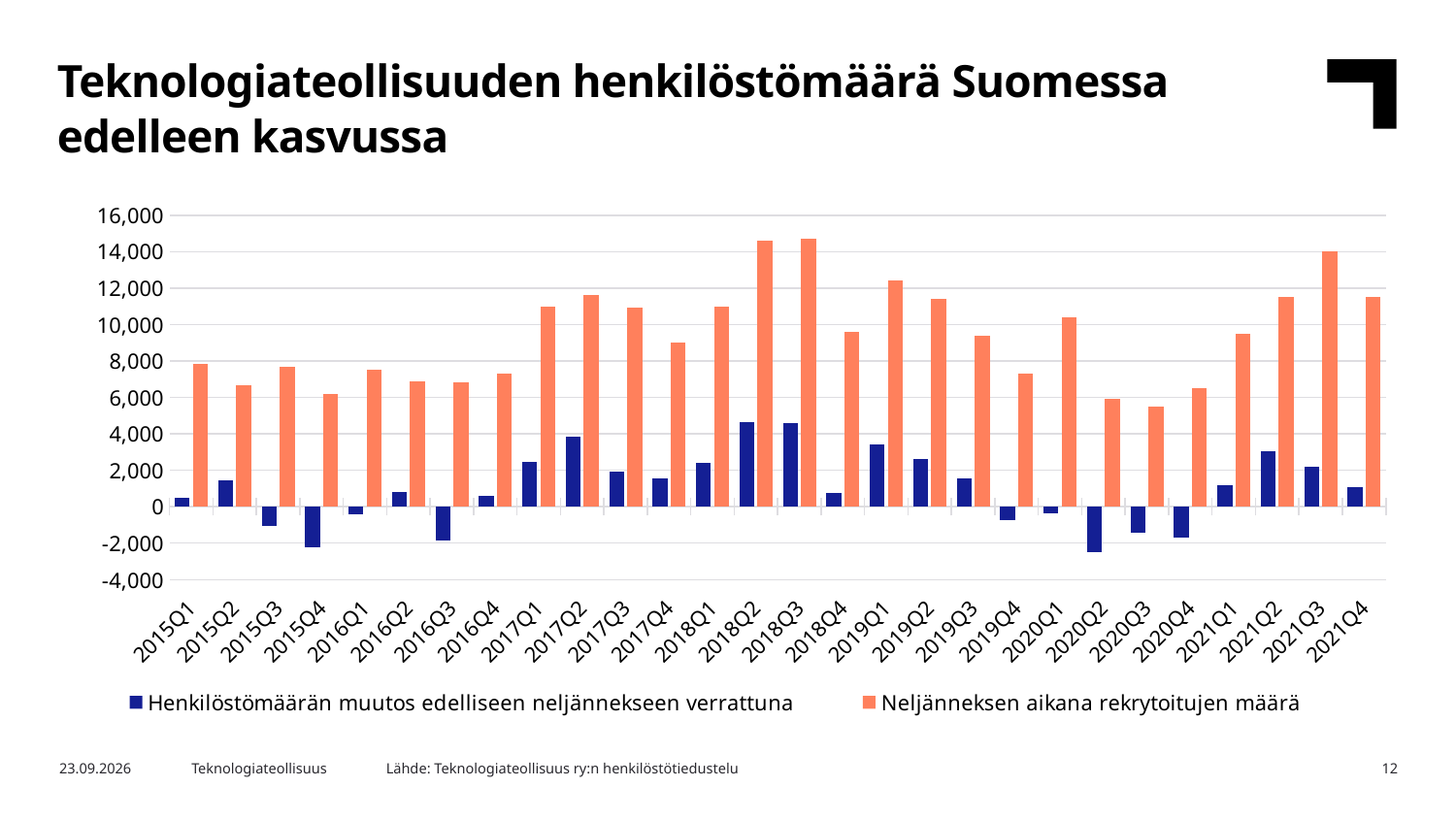
Is the value of 'Neljänneksen aikana rekrytoitujen määrä' for 2021Q3 greater or less than 12,000? greater Which colour represents 'Neljänneksen aikana rekrytoitujen määrä' in the legend? Orange Which is larger for 'Neljänneksen aikana rekrytoitujen määrä': 2019Q1 or 2019Q2? 2019Q1 How many quarters are shown on the x axis? 28 Does the value of 'Neljänneksen aikana rekrytoitujen määrä' rise or fall from 2020Q3 to 2021Q3? rise How many series does the legend list? 2 Is the value of 'Neljänneksen aikana rekrytoitujen määrä' for 2018Q2 greater or less than 14,000? greater Is the value of 'Henkilöstömäärän muutos edelliseen neljännekseen verrattuna' for 2017Q2 greater or less than 2,000? greater What kind of chart is shown on the slide? Bar chart Which is larger for 'Henkilöstömäärän muutos edelliseen neljännekseen verrattuna': 2017Q2 or 2017Q3? 2017Q2